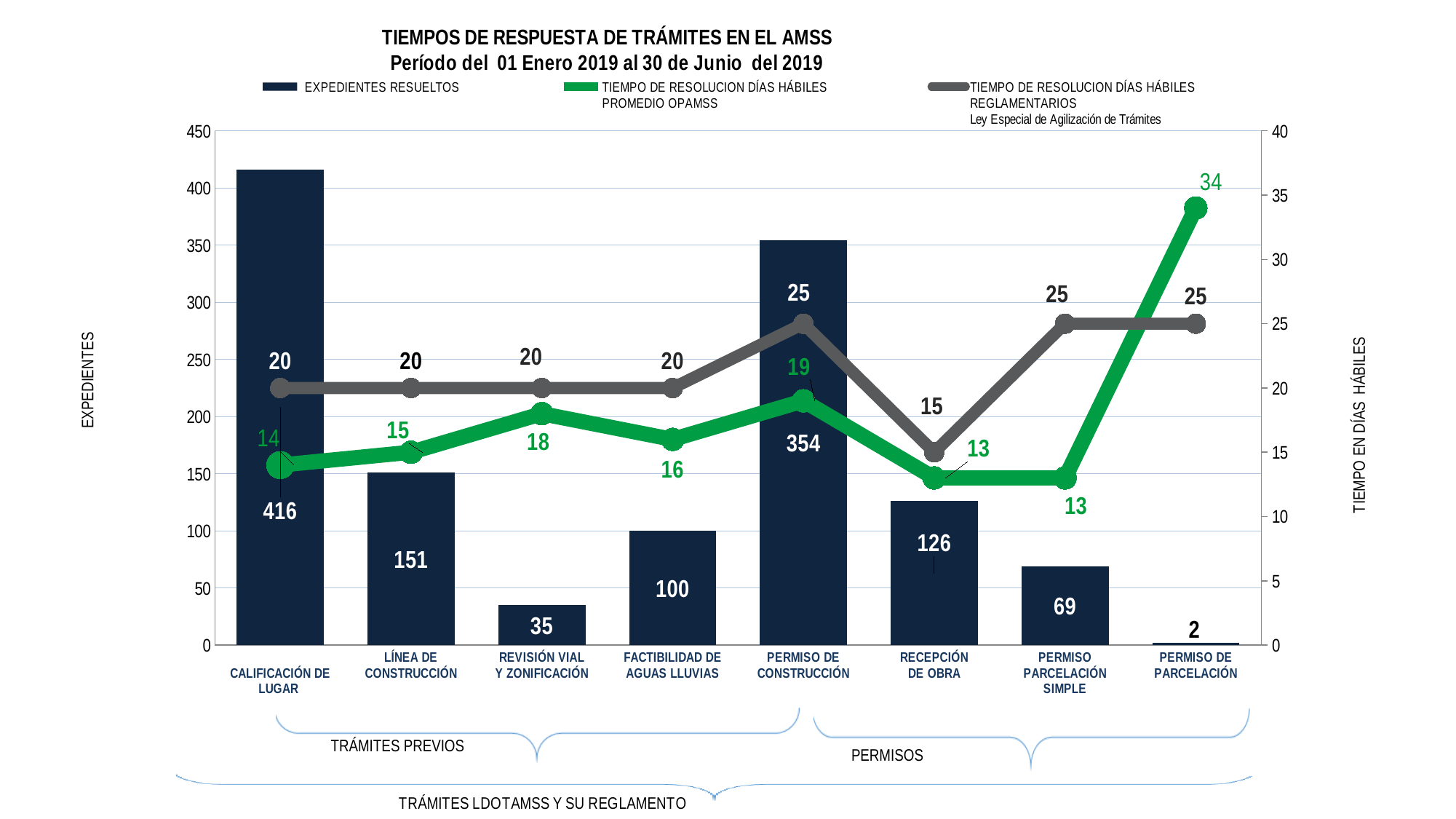
How many categories are shown on the x axis? 8 Which category has the lowest number of EXPEDIENTES RESUELTOS? PERMISO DE PARCELACIÓN Which category has the highest number of EXPEDIENTES RESUELTOS? CALIFICACIÓN DE LUGAR How many series does the legend list? 3 Which category has the highest TIEMPO DE RESOLUCION DÍAS HÁBILES PROMEDIO OPAMSS? PERMISO DE PARCELACIÓN For PERMISO DE CONSTRUCCIÓN, which is larger: the TIEMPO DE RESOLUCION DÍAS HÁBILES PROMEDIO OPAMSS or the TIEMPO DE RESOLUCION DÍAS HÁBILES REGLAMENTARIOS? TIEMPO DE RESOLUCION DÍAS HÁBILES REGLAMENTARIOS What is the TIEMPO DE RESOLUCION DÍAS HÁBILES REGLAMENTARIOS value for RECEPCIÓN DE OBRA? 15 What is the TIEMPO DE RESOLUCION DÍAS HÁBILES PROMEDIO OPAMSS value for PERMISO DE PARCELACIÓN? 34 How many expedientes resueltos are shown for CALIFICACIÓN DE LUGAR? 416 What kind of chart is this? Combined bar and line chart What is the title of the right-hand vertical axis? TIEMPO EN DÍAS HÁBILES What is the difference in EXPEDIENTES RESUELTOS between PERMISO DE CONSTRUCCIÓN and RECEPCIÓN DE OBRA? 228